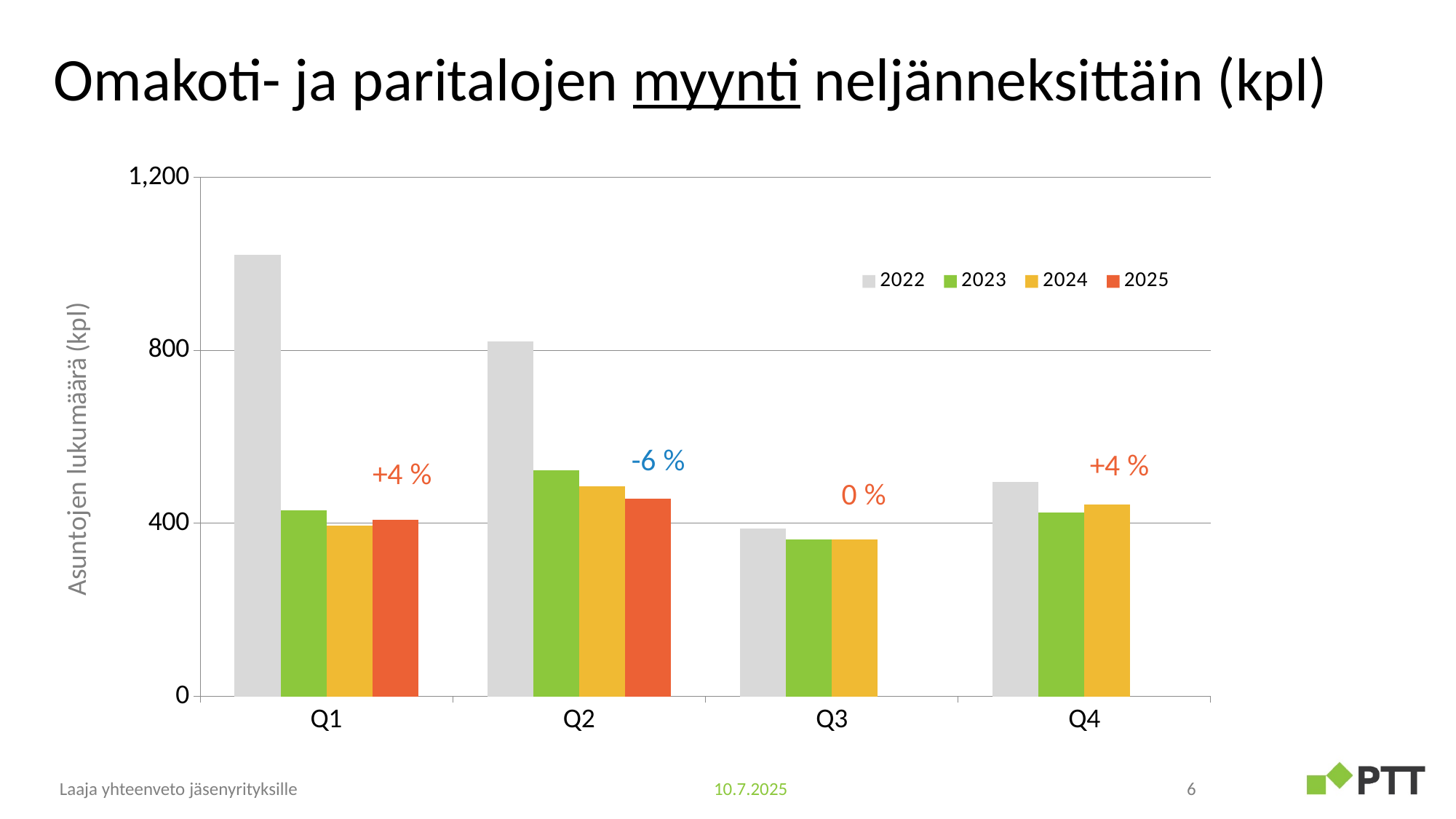
Is the 2024 value for Q3 greater or less than 400? less For how many quarters is a 2025 bar plotted? 2 Does the 2022 series rise or fall from Q1 to Q3? fall Which is larger, the 2023 value for Q2 or the 2023 value for Q3? Q2 In which quarter is the 2022 value lowest? Q3 What percentage change is annotated above the Q2 group? -6 % Is the 2023 value for Q2 greater or less than 400? greater Is the 2022 value for Q1 greater or less than 800? greater In which quarter is the 2022 value highest? Q1 How many series does the legend list? 4 What kind of chart is shown on the slide? bar chart How many quarters are shown on the x axis? 4